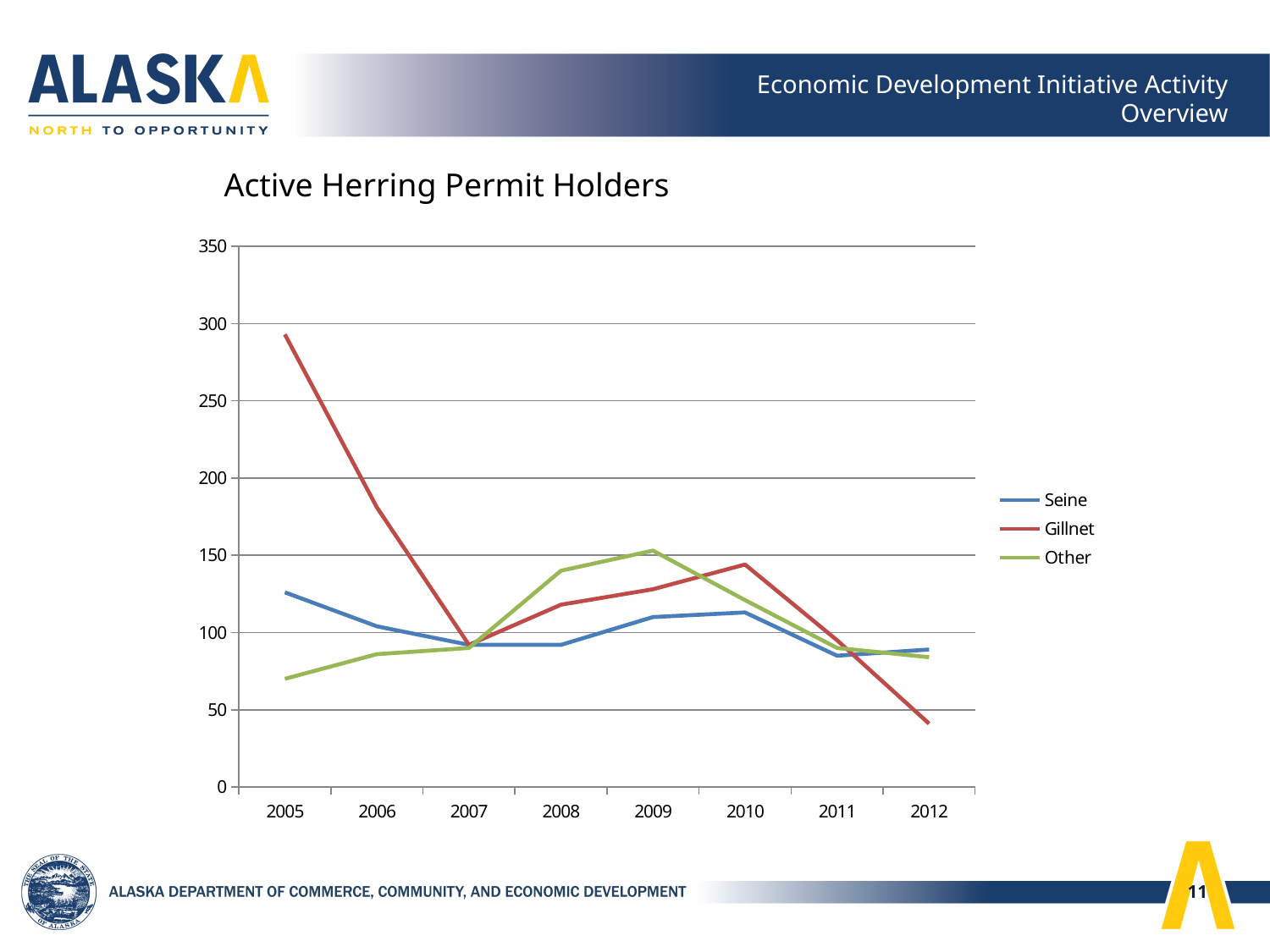
Is the value for Other in 2005 greater or less than 100? less Is the value for Gillnet in 2012 greater or less than 50? less How many series does the legend list? 3 Is the value for Gillnet in 2005 greater or less than 250? greater What kind of chart is shown on the slide? line chart Which series has the lowest value in 2012? Gillnet Does the Gillnet line rise or fall from 2005 to 2007? fall What is the title of the chart? Active Herring Permit Holders Which series has the highest value in 2005? Gillnet In 2005, which is larger, the value for Seine or the value for Other? Seine How many years are shown along the x axis? 8